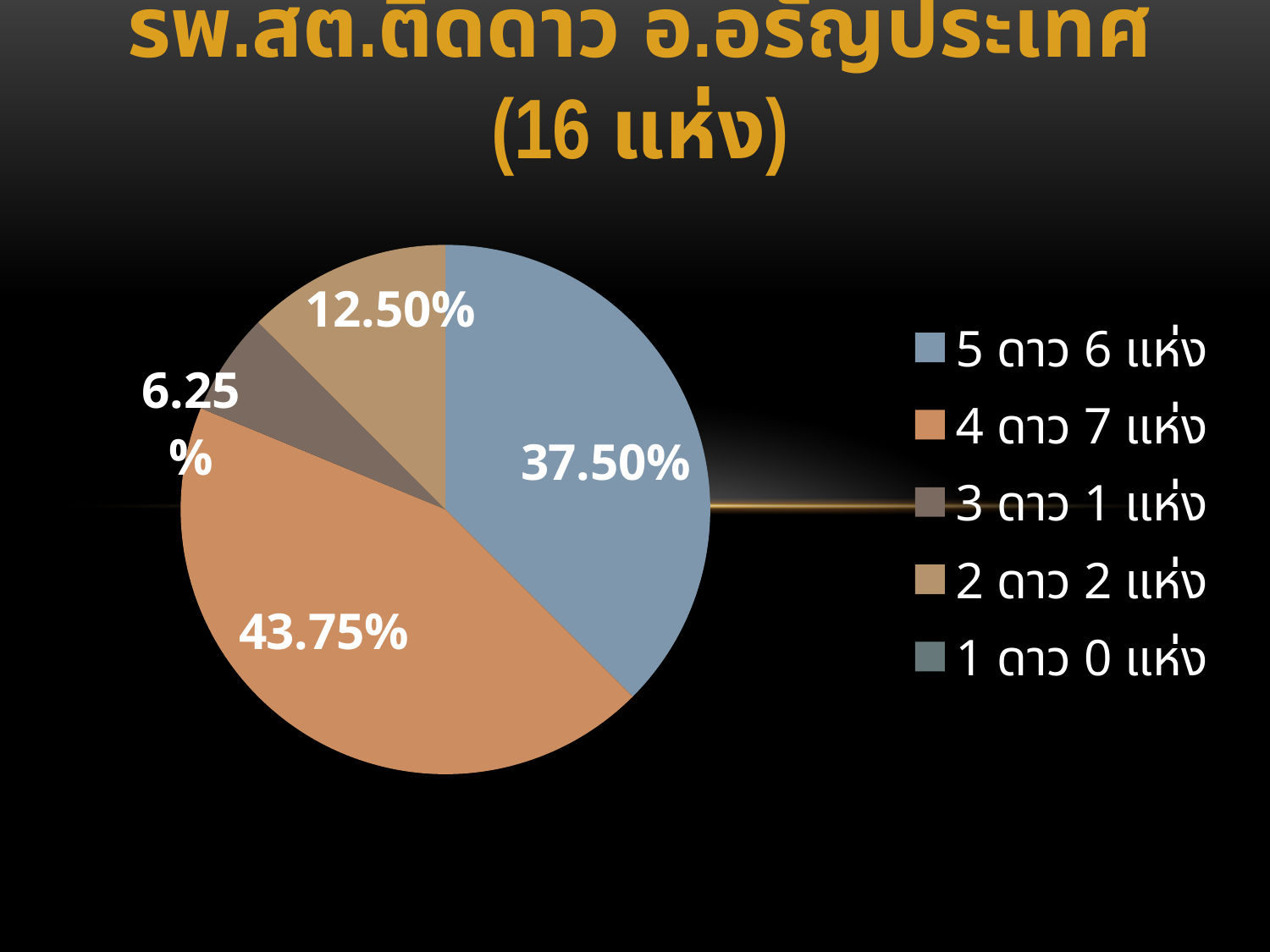
What percentage of the pie does the "4 ดาว 7 แห่ง" slice represent? 43.75% What kind of chart is shown on the slide? pie chart What is the title of the chart? รพ.สต.ติดดาว อ.อรัญประเทศ (16 แห่ง) How many entries does the legend list? 5 What percentage of the pie does the "3 ดาว 1 แห่ง" slice represent? 6.25% What percentage of the pie does the "2 ดาว 2 แห่ง" slice represent? 12.50% What is the difference in percentage points between the "4 ดาว 7 แห่ง" slice and the "5 ดาว 6 แห่ง" slice? 6.25% Which category has the largest slice of the pie? 4 ดาว 7 แห่ง What colour is the "5 ดาว 6 แห่ง" slice? blue Which slice is larger: "2 ดาว 2 แห่ง" or "3 ดาว 1 แห่ง"? 2 ดาว 2 แห่ง Which of the visible slices is the smallest? 3 ดาว 1 แห่ง